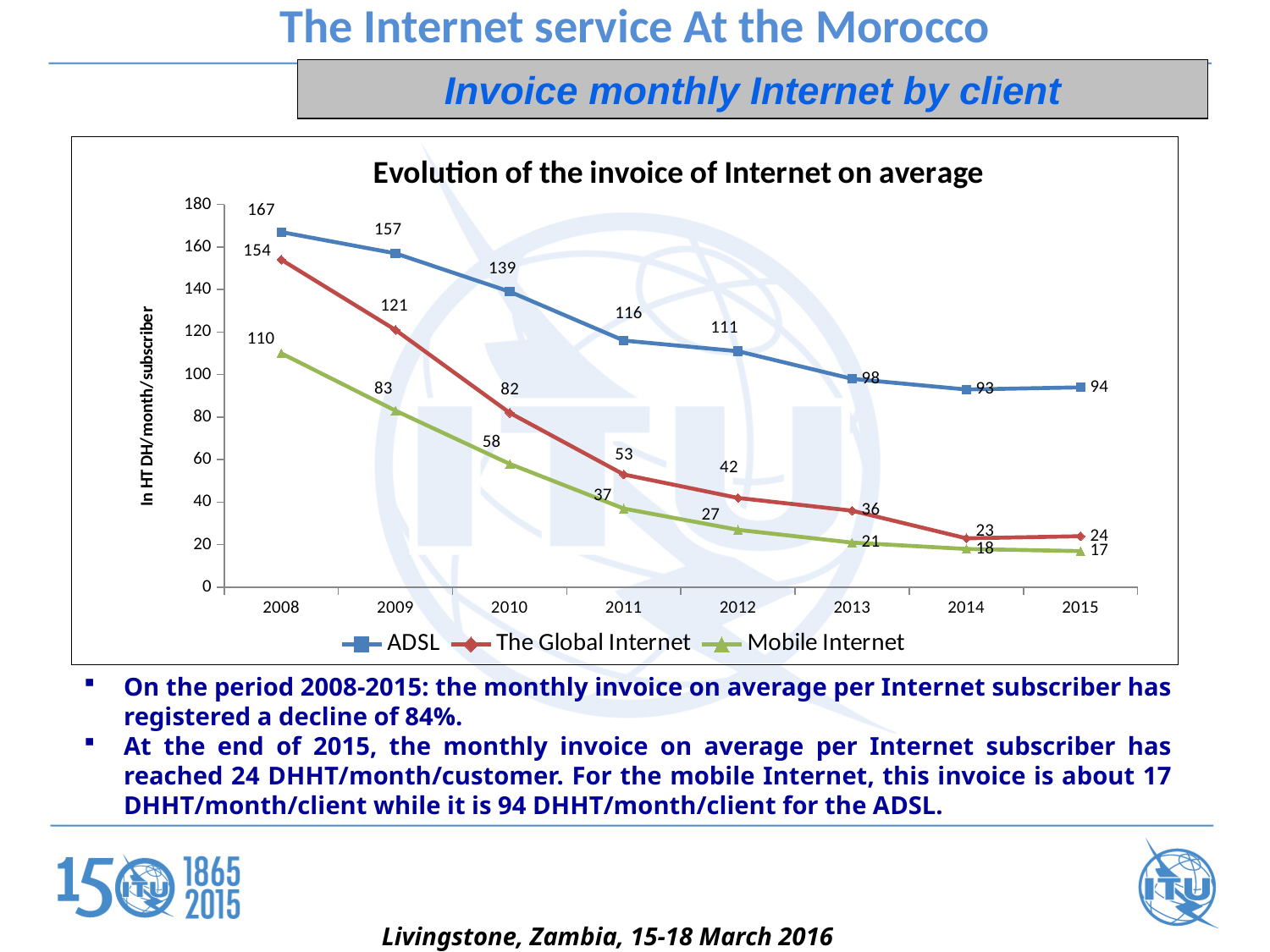
What is the difference between the ADSL value in 2008 and the ADSL value in 2015? 73 Which year has the highest ADSL value? 2008 How many series does the legend list? 3 Which is larger in 2012: the ADSL value or The Global Internet value? ADSL How many years are shown on the x axis? 8 Which year has the lowest Mobile Internet value? 2015 What kind of chart is shown? line chart What is the value for The Global Internet in 2011? 53 What is the ADSL value in 2008? 167 Is the ADSL value in 2010 greater or less than 120? greater Do the Mobile Internet values rise or fall from 2008 to 2015? fall What is the Mobile Internet value in 2015? 17